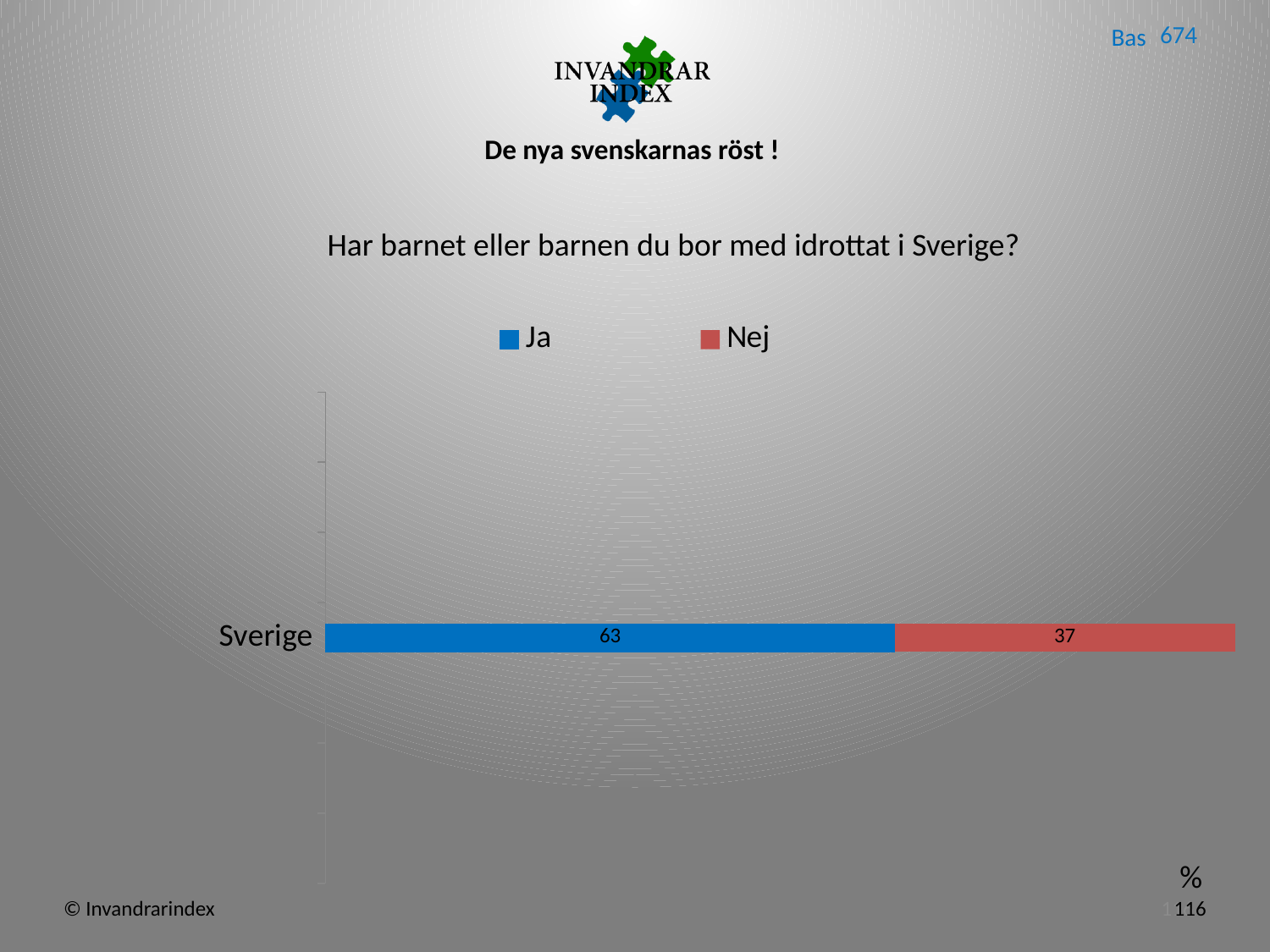
What is the total of the stacked bar for Sverige? 100 What is the difference between the Ja and Nej values for Sverige? 26 How many series does the legend list? 2 Which series has the higher value for Sverige, Ja or Nej? Ja What kind of chart is shown on the slide? Stacked bar chart Which colour represents the Nej series? Red Which series has the lowest value for Sverige? Nej What is the value for Ja for Sverige? 63 What is the title of the chart? Har barnet eller barnen du bor med idrottat i Sverige? What is the name of the category shown on the chart? Sverige How many categories are plotted on the chart? 1 What is the value for Nej for Sverige? 37